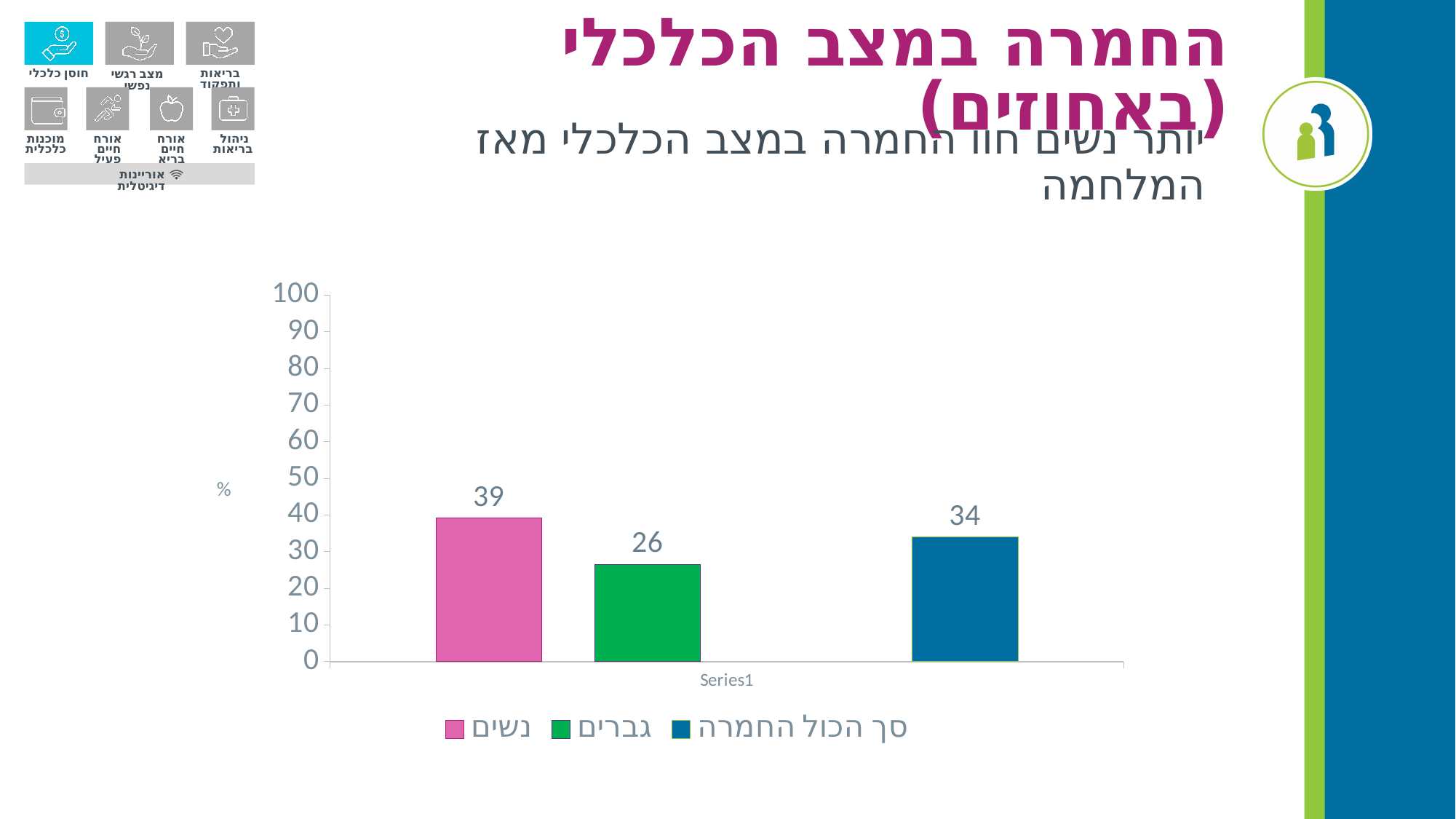
Which is larger, the value for גברים or the value for סך הכול החמרה? סך הכול החמרה What is the difference between the values for נשים and סך הכול החמרה? 5 Is the value for גברים greater or less than 30? less What is the difference between the values for נשים and גברים? 13 What is the value for נשים (women)? 39 Which series has the highest value? נשים What kind of chart is shown on the slide? bar chart What colour is the bar for נשים? pink What is the value for סך הכול החמרה (total worsening)? 34 What is the value for גברים (men)? 26 How many series does the legend list? 3 Which series has the lowest value? גברים